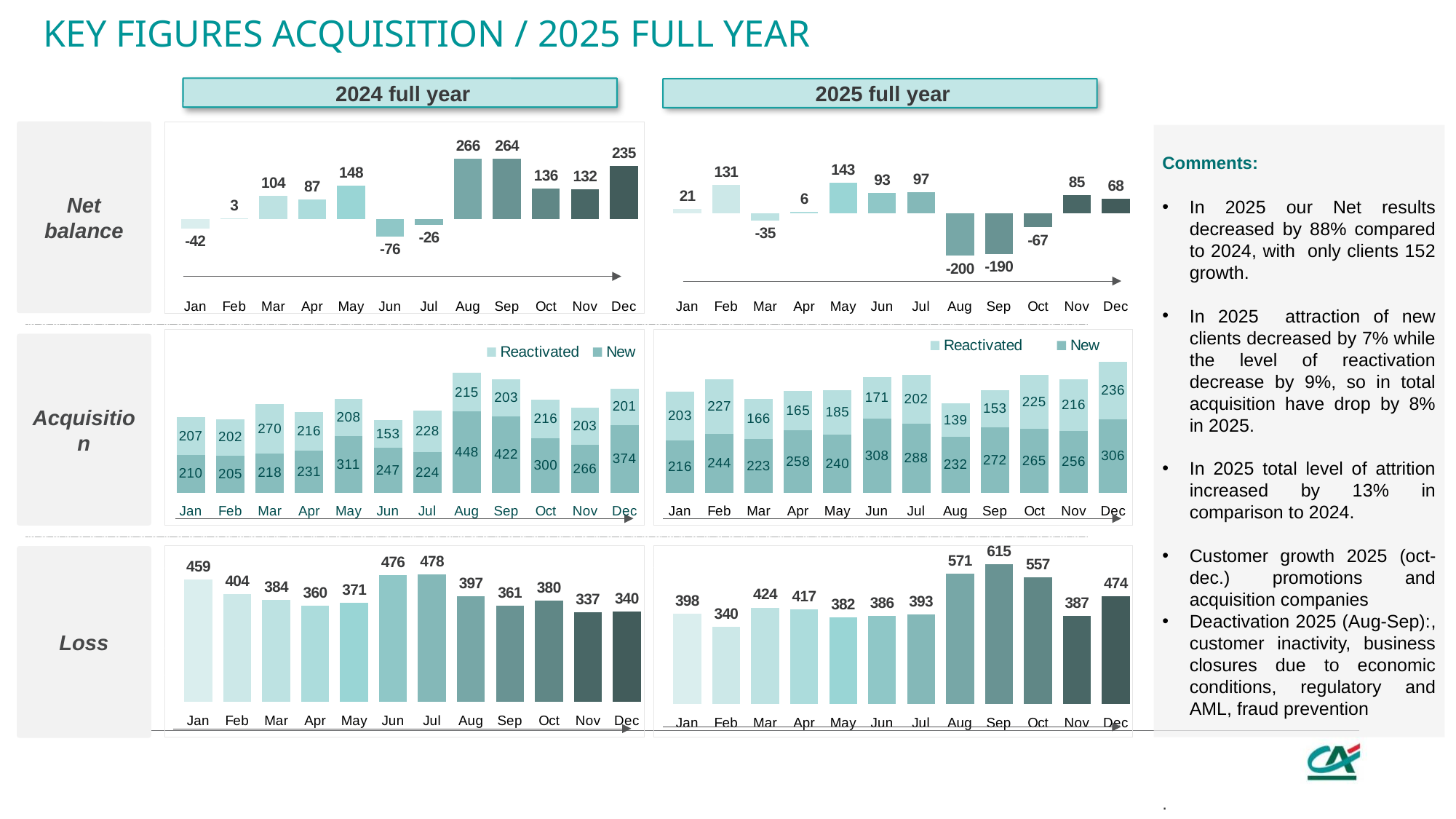
In the Acquisition chart for 2024 full year, what is the total of the stacked bar for Aug (Reactivated plus New)? 663 In the Acquisition chart for 2025 full year, what is the New value for Jun? 308 In the Loss chart for 2025 full year, which month has the highest value? Sep In the Loss chart for 2025 full year, which is larger, the value for Aug or the value for Oct? Aug What kind of chart is the Loss chart for 2025 full year? Bar chart In the Loss chart for 2024 full year, what is the difference between the Jul value and the Dec value? 138 In the Net balance chart for 2025 full year, which month has the lowest value? Aug How many bars are shown in the Loss chart for 2024 full year? 12 What are the two legend entries in the Acquisition chart for 2024 full year? Reactivated and New How many series does the legend list in the Acquisition chart for 2025 full year? 2 In the Net balance chart for 2025 full year, what is the value for Oct? -67 In the Net balance chart for 2024 full year, what is the value for Aug? 266